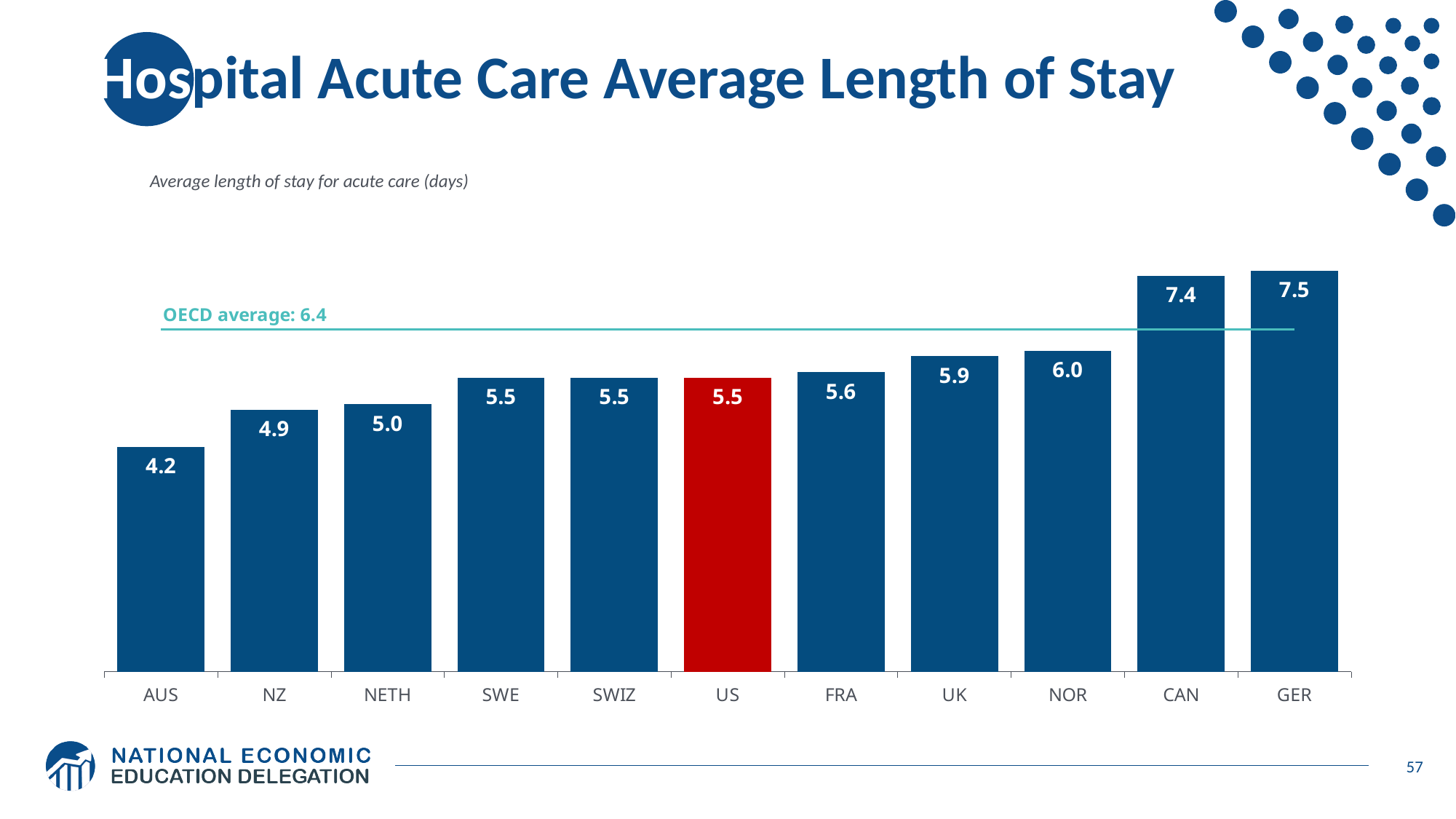
Which country has the lowest average length of stay for acute care? AUS What is the average length of stay for acute care in Germany (GER)? 7.5 How many countries are shown on the chart? 11 Which has a longer average length of stay, UK or NZ? UK What is the value shown for NOR? 6.0 Do the values generally rise or fall from left to right along the x axis? Rise What is the average length of stay for acute care in the US? 5.5 Which country has the highest average length of stay for acute care? GER What is the difference between the values for GER and AUS? 3.3 What OECD average value is marked by the horizontal line on the chart? 6.4 What is the difference between the values for CAN and US? 1.9 What kind of chart is shown on the slide? Bar chart